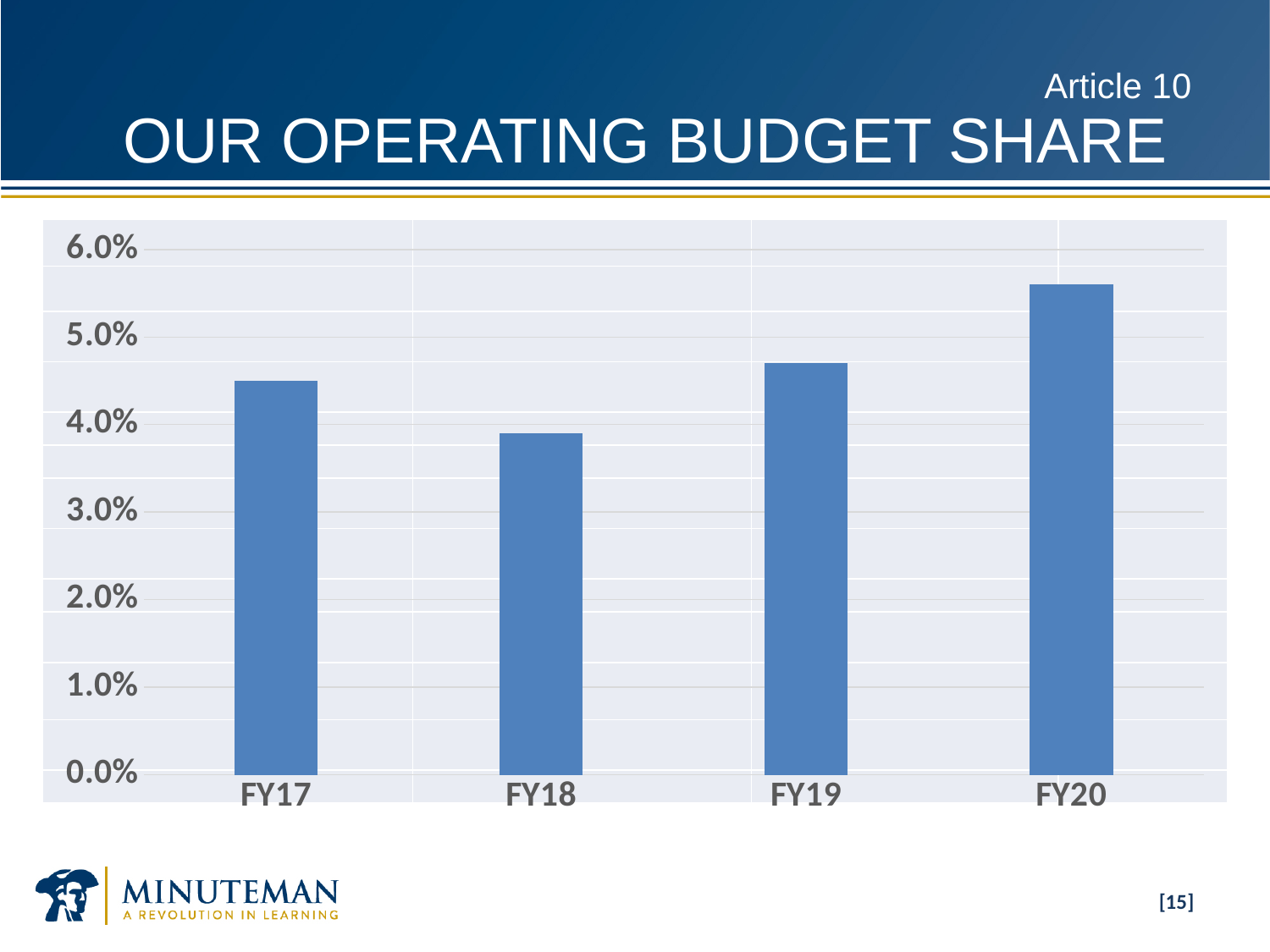
What is the highest tick label shown on the vertical axis? 6.0% How many fiscal years are plotted in the chart? 4 Which fiscal year has the lowest operating budget share? FY18 Is the value for FY20 greater or less than 6.0%? less Which fiscal year has the highest operating budget share? FY20 Is the value for FY20 greater or less than 5.0%? greater What is the title of the slide containing the chart? OUR OPERATING BUDGET SHARE Do the values rise or fall from FY18 to FY20? rise Which is larger, the value for FY17 or the value for FY18? FY17 Is the value for FY17 greater or less than 4.0%? greater What kind of chart is shown on the slide? bar chart